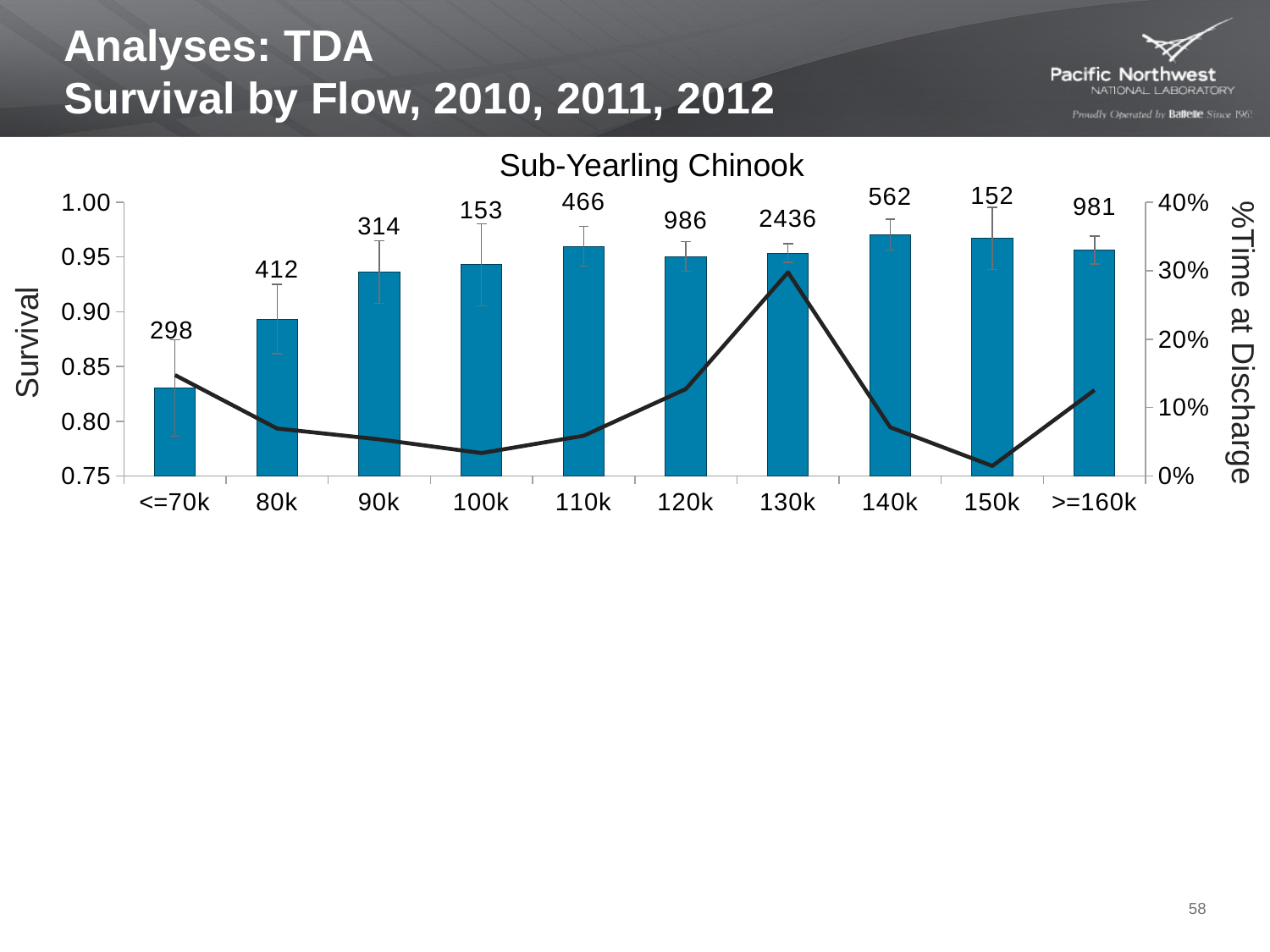
Which flow category has the lowest Survival bar? <=70k What number is printed above the bar for <=70k? 298 What kind of chart is used to show Survival? Bar chart What number is printed above the bar for 150k? 152 Is the Survival value for 110k greater or less than 0.95? greater At which flow category does the %Time at Discharge line reach its highest point? 130k What number is printed above the bar for 130k? 2436 Which has the higher Survival bar, <=70k or 80k? 80k What is the title of the chart? Sub-Yearling Chinook Is the Survival value for <=70k greater or less than 0.85? less How many flow categories are shown on the x axis? 10 Is the %Time at Discharge value for 130k greater or less than 20%? greater